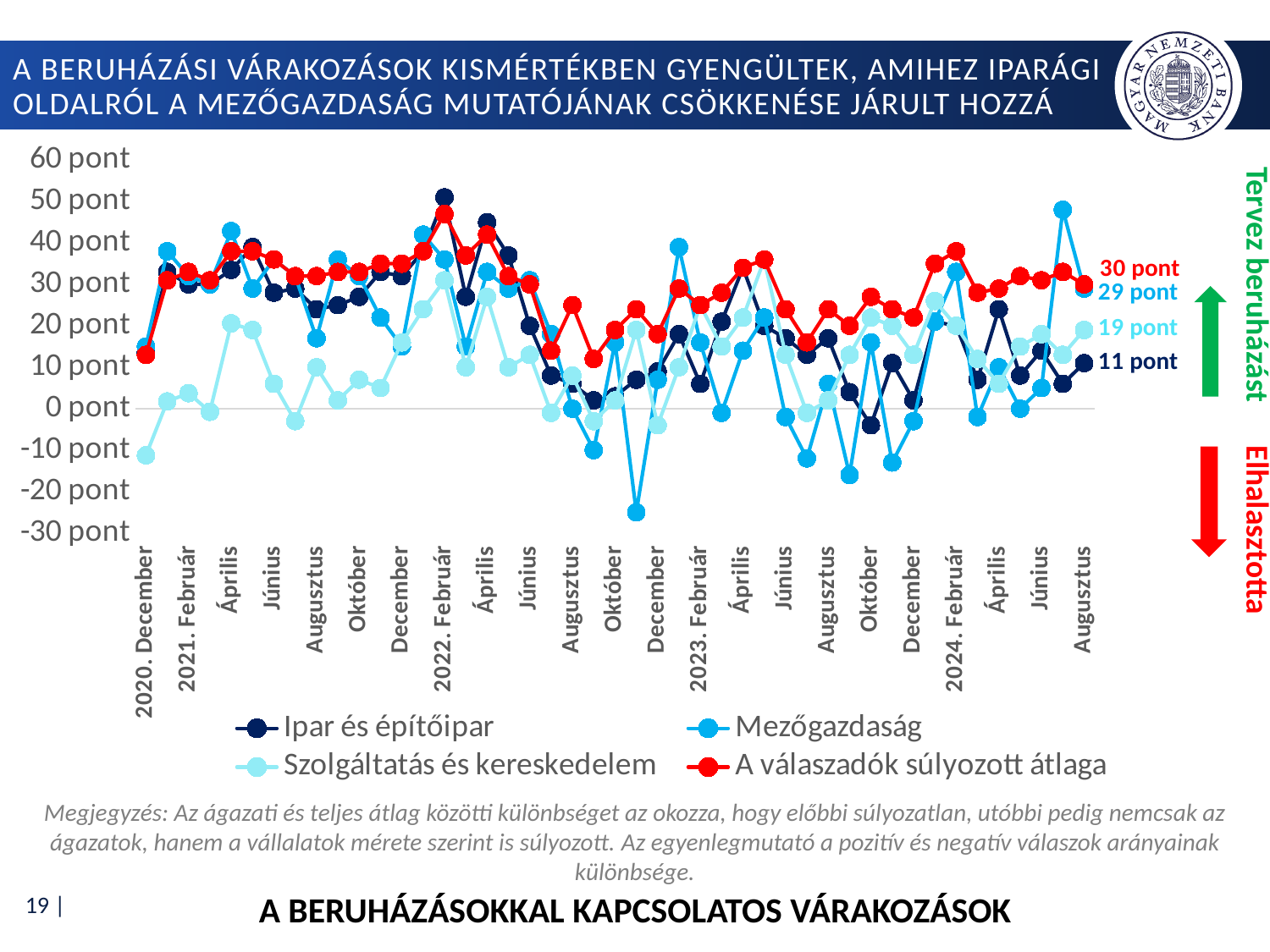
How many series does the legend list? 4 What kind of chart is shown on the slide? line chart What is the value of Ipar és építőipar at the last point (2024 Augusztus)? 11 pont What is the value of Mezőgazdaság at the last point (2024 Augusztus)? 29 pont Which series has the highest value at the last point (2024 Augusztus)? A válaszadók súlyozott átlaga What is the value of A válaszadók súlyozott átlaga at the last point (2024 Augusztus)? 30 pont What is the difference between A válaszadók súlyozott átlaga and Ipar és építőipar at the last point (2024 Augusztus)? 19 pont Is the value of Ipar és építőipar in 2022 Február greater or less than 40 pont? greater Which series has the lowest value at the last point (2024 Augusztus)? Ipar és építőipar What is the value of Szolgáltatás és kereskedelem at the last point (2024 Augusztus)? 19 pont Which series is drawn in red? A válaszadók súlyozott átlaga At the last point (2024 Augusztus), which is larger: Mezőgazdaság or Szolgáltatás és kereskedelem? Mezőgazdaság